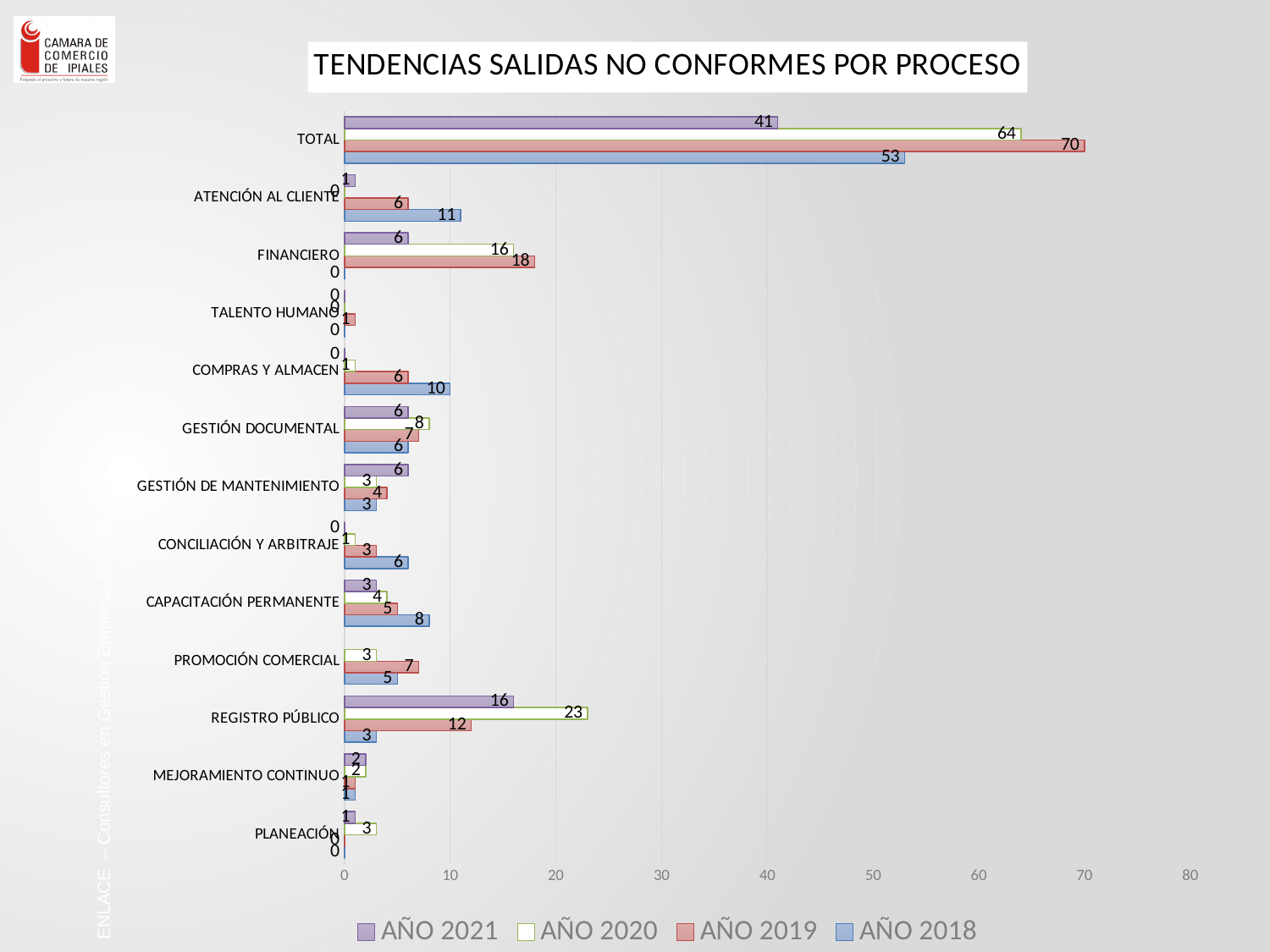
What kind of chart is shown on the slide? Bar chart What is the difference between the AÑO 2020 and AÑO 2021 values for TOTAL? 23 Which year has the highest TOTAL value? AÑO 2019 How many series does the legend list? 4 Which is larger for REGISTRO PÚBLICO, the AÑO 2021 value or the AÑO 2019 value? AÑO 2021 What is the AÑO 2021 value for FINANCIERO? 6 What is the title of the chart? TENDENCIAS SALIDAS NO CONFORMES POR PROCESO What is the AÑO 2020 value for REGISTRO PÚBLICO? 23 What is the AÑO 2018 value for ATENCIÓN AL CLIENTE? 11 Is the AÑO 2018 value for TOTAL greater or less than 50? greater Which year has the lowest TOTAL value? AÑO 2021 What is the AÑO 2019 value for TOTAL? 70